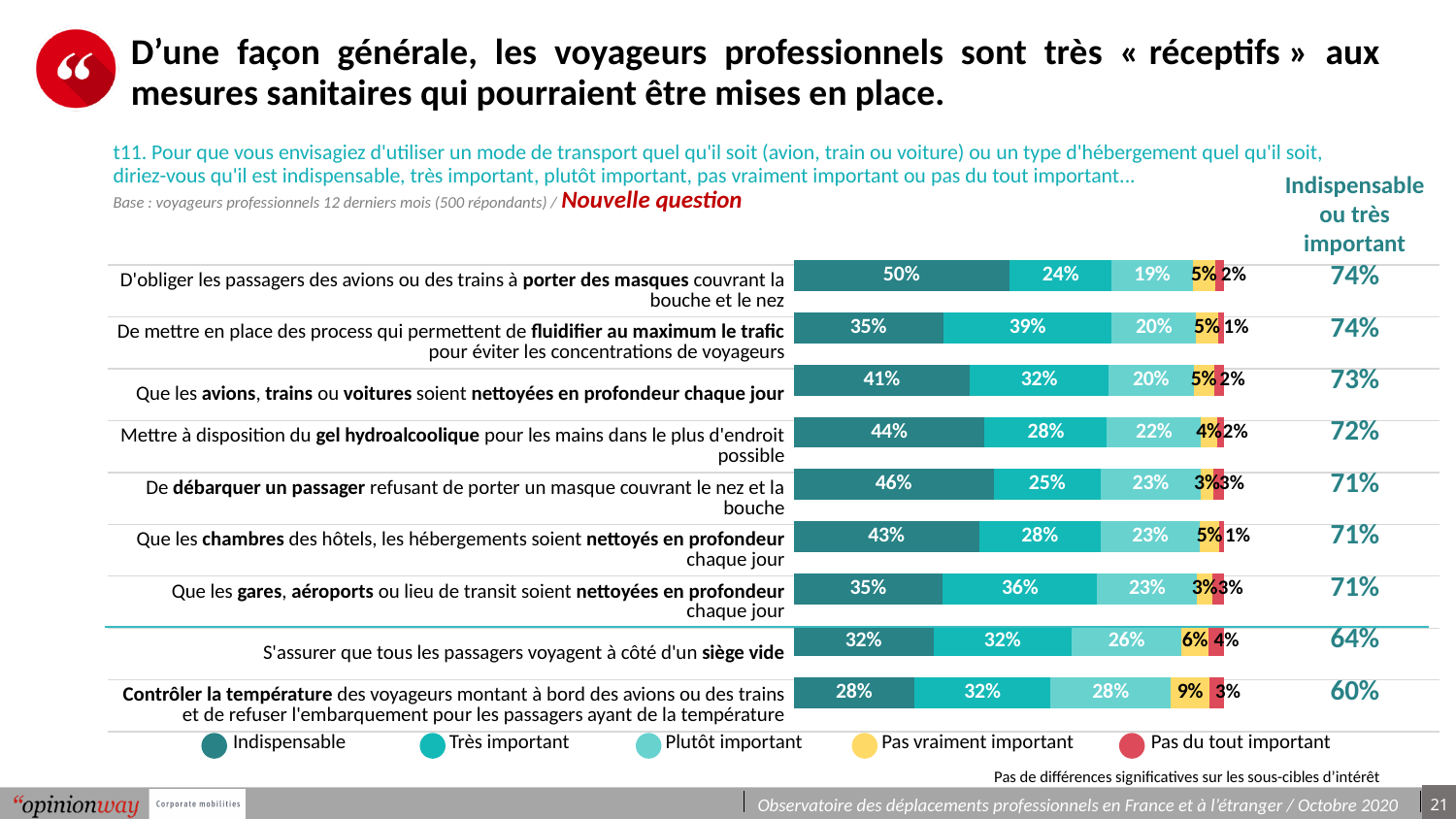
What is the total of the stacked bar for Contrôler la température des voyageurs (28% + 32% + 28% + 9% + 3%)? 100% How many series does the legend list? 5 Which measure has the highest "Indispensable" share? D'obliger les passagers des avions ou des trains à porter des masques How many measures (bars) are shown in the chart? 9 Which has a larger "Plutôt important" value: S'assurer que tous les passagers voyagent à côté d'un siège vide, or Mettre à disposition du gel hydroalcoolique? S'assurer que tous les passagers voyagent à côté d'un siège vide What percentage of respondents consider it "Indispensable" to require passengers on planes or trains to wear masks (porter des masques)? 50% What is the combined "Indispensable ou très important" value shown for the measure about gel hydroalcoolique? 72% Which measure has the lowest "Indispensable" share? Contrôler la température des voyageurs What is the "Pas vraiment important" value for the measure Contrôler la température des voyageurs? 9% What type of chart is used on this slide? Stacked bar chart What is the difference between the "Indispensable" values for porter des masques (50%) and Contrôler la température (28%)? 22% What is the "Très important" value for the measure about fluidifier au maximum le trafic? 39%